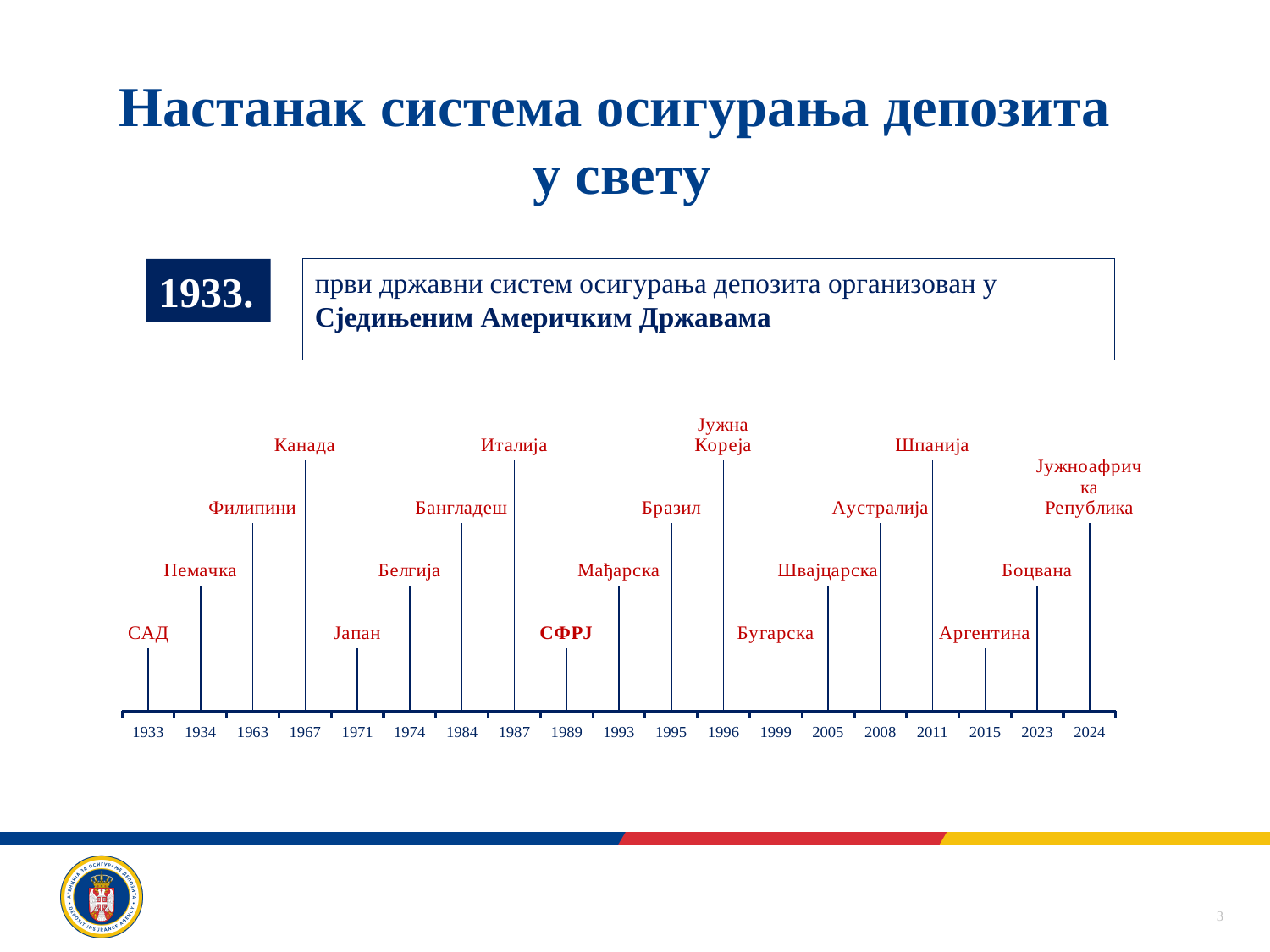
How many years separate Јапан and Канада on the timeline? 4 In which year is Канада placed on the timeline? 1967 What is the first year shown on the timeline axis? 1933 What kind of chart is shown on the slide? timeline Which was marked earlier on the timeline, Бразил or Мађарска? Мађарска Which country appears at the latest year on the timeline? Јужноафричка Република How many countries are marked on the timeline? 19 In which year is Јужна Кореја placed on the timeline? 1996 Which country appears at the earliest year on the timeline? САД Which country is marked at 2015 on the timeline? Аргентина Which country is marked at 1989 on the timeline? СФРЈ In which year is Бангладеш placed on the timeline? 1984